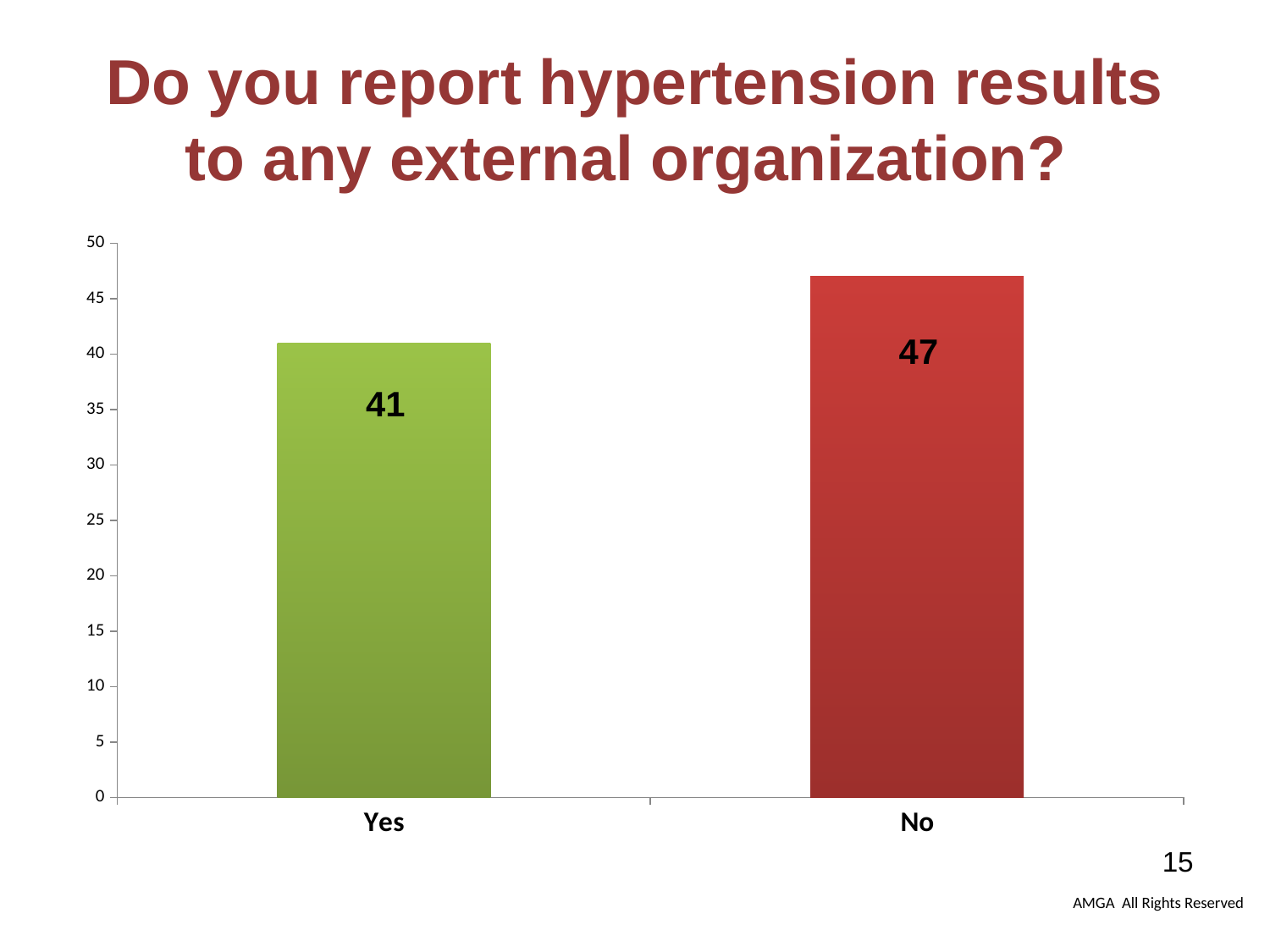
What is the value for Yes? 41 What kind of chart is shown on the slide? bar chart Which category has the highest value? No What is the difference between the values for No and Yes? 6 What is the value for No? 47 Which is larger, the value for Yes or the value for No? No Which category has the lowest value? Yes How many categories are shown on the chart? 2 What colour is the bar for No? red What is the title of the slide? Do you report hypertension results to any external organization? Is the value for No greater or less than 45? greater Is the value for Yes greater or less than 45? less